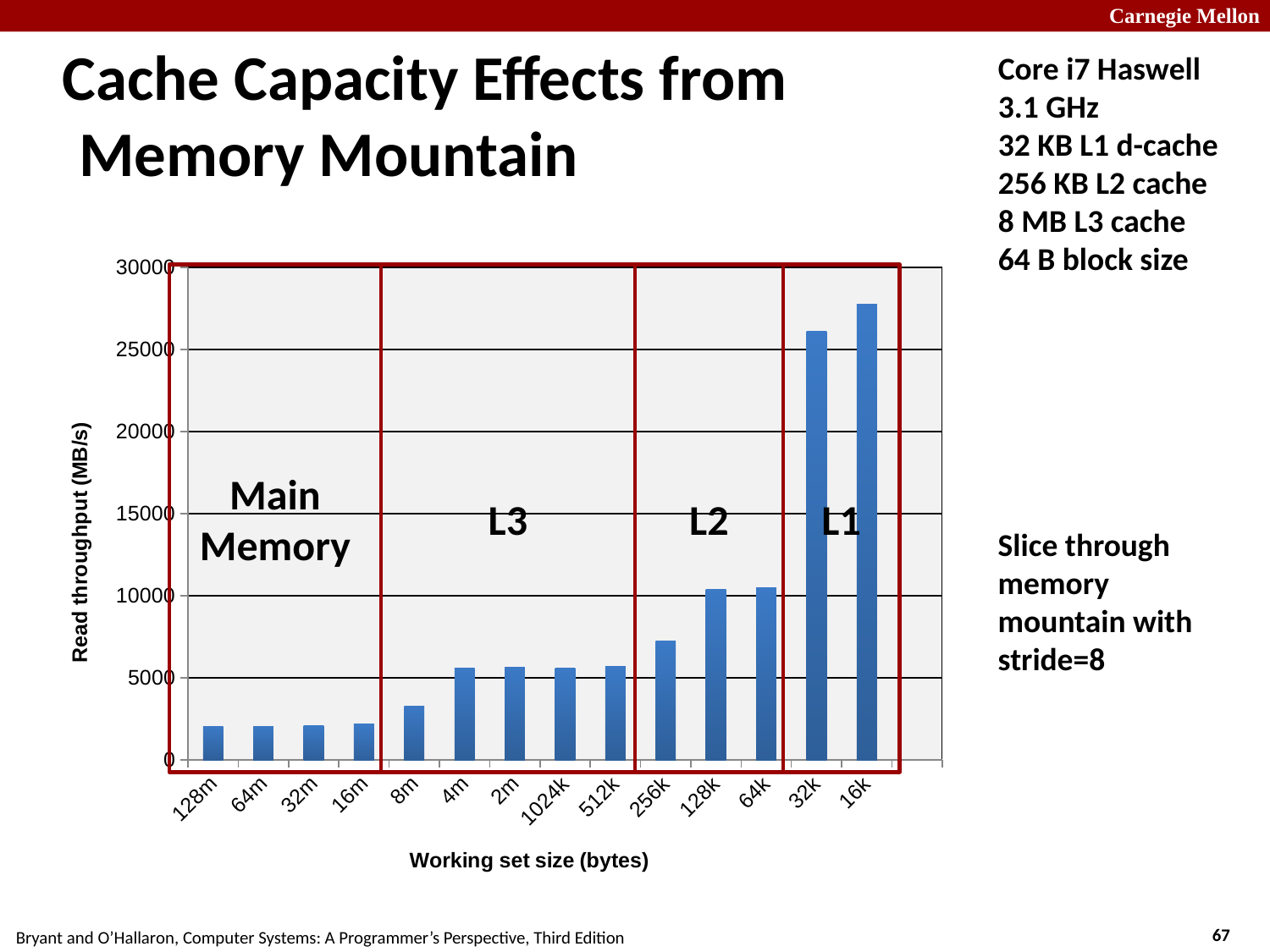
What is the label of the y axis? Read throughput (MB/s) Is the read throughput for a working set size of 128m greater or less than 5000 MB/s? less Which has the higher read throughput: a working set size of 16k or 32k? 16k Is the read throughput for a working set size of 256k greater or less than 10000 MB/s? less Which working set size has the highest read throughput? 16k Is the read throughput for a working set size of 8m greater or less than 5000 MB/s? less What are the four region labels written over the chart, from left to right? Main Memory, L3, L2, L1 How many working set sizes (bars) are plotted on the chart? 14 What kind of chart is shown on the slide? bar chart Which has the higher read throughput: a working set size of 256k or 128k? 128k Do the bars generally rise or fall moving from left (128m) to right (16k) along the x axis? rise